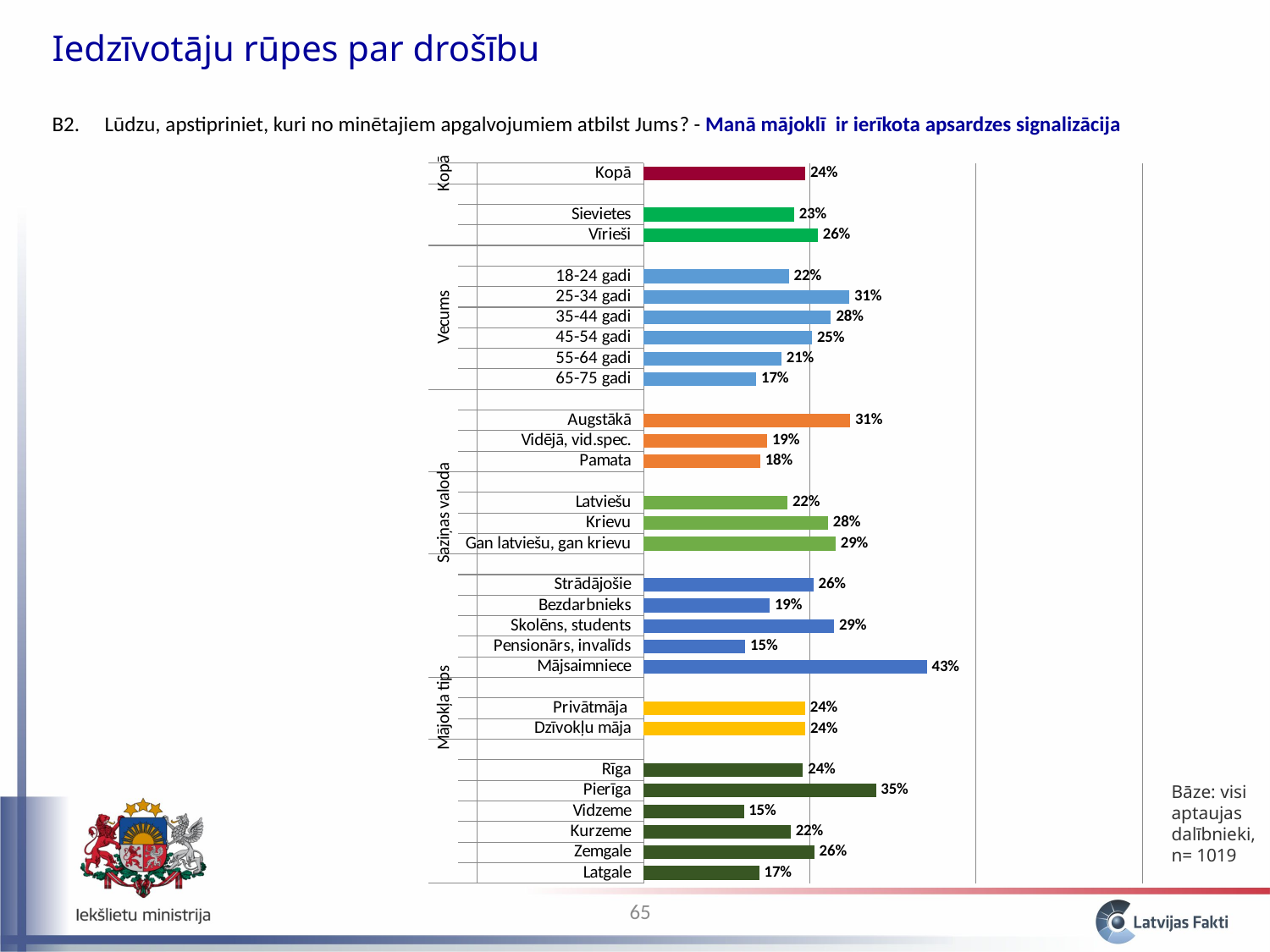
Which category has the highest value in the chart? Mājsaimniece What type of chart is shown on the slide? Bar chart How many bars are plotted in the chart? 28 Which is larger, the value for Krievu or the value for Latviešu? Krievu Among the regions (Rīga, Pierīga, Vidzeme, Kurzeme, Zemgale, Latgale), which has the lowest value? Vidzeme What is the difference between the values for Augstākā and Pamata? 13% What is the difference between the values for Vīrieši and Sievietes? 3% What is the value for 65-75 gadi? 17% Which is larger, the value for 25-34 gadi or the value for 55-64 gadi? 25-34 gadi What is the value for Kopā? 24% What is the value for Mājsaimniece? 43% What is the value for Pierīga? 35%